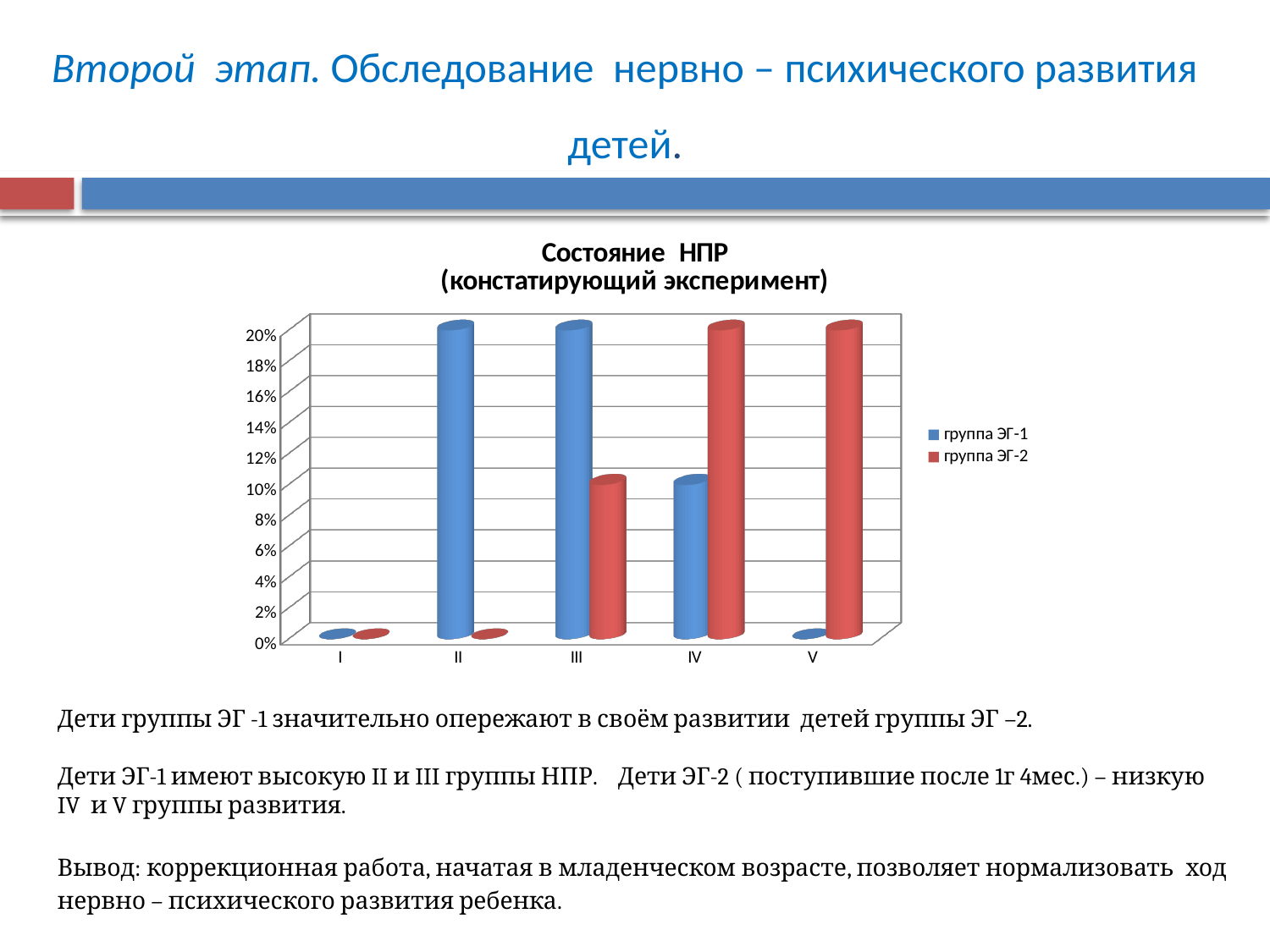
Is the value for группа ЭГ-2 in category IV greater or less than 10%? greater What is the value for группа ЭГ-2 in category V? 20% What kind of chart is shown on the slide? bar chart Which series is shown in red? группа ЭГ-2 What is the value for группа ЭГ-2 in category III? 10% What is the value for группа ЭГ-1 in category IV? 10% How many series does the legend list? 2 Which is larger in category III, группа ЭГ-1 or группа ЭГ-2? группа ЭГ-1 What is the value for группа ЭГ-1 in category II? 20% What is the title of the chart? Состояние НПР (констатирующий эксперимент) How many categories are shown on the x axis? 5 Which is larger in category IV, группа ЭГ-1 or группа ЭГ-2? группа ЭГ-2